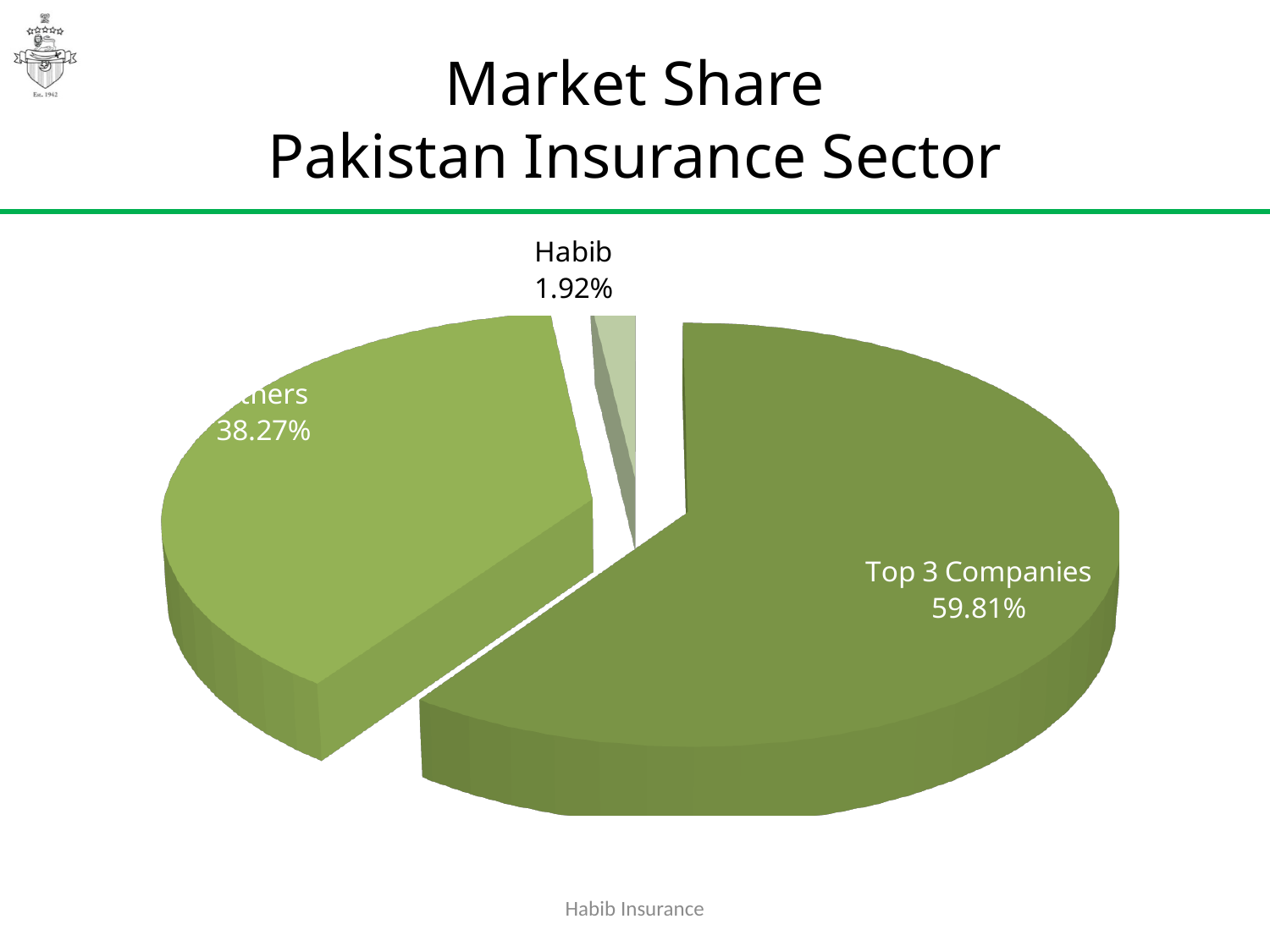
What is the title of the slide containing the chart? Market Share Pakistan Insurance Sector What share of the market do the Top 3 Companies hold? 59.81% Which has a larger market share, Habib or Others? Others What percentage is shown for the Others slice? 38.27% What is Habib's market share shown on the pie chart? 1.92% Is the market share of the Top 3 Companies greater or less than 50%? greater How many slices does the pie chart have? 3 What type of chart is shown on the slide? Pie chart Which slice of the pie chart is the smallest? Habib Which slice of the pie chart is the largest? Top 3 Companies What is the difference in market share between the Top 3 Companies and Others? 21.54% What is the difference in market share between Others and Habib? 36.35%